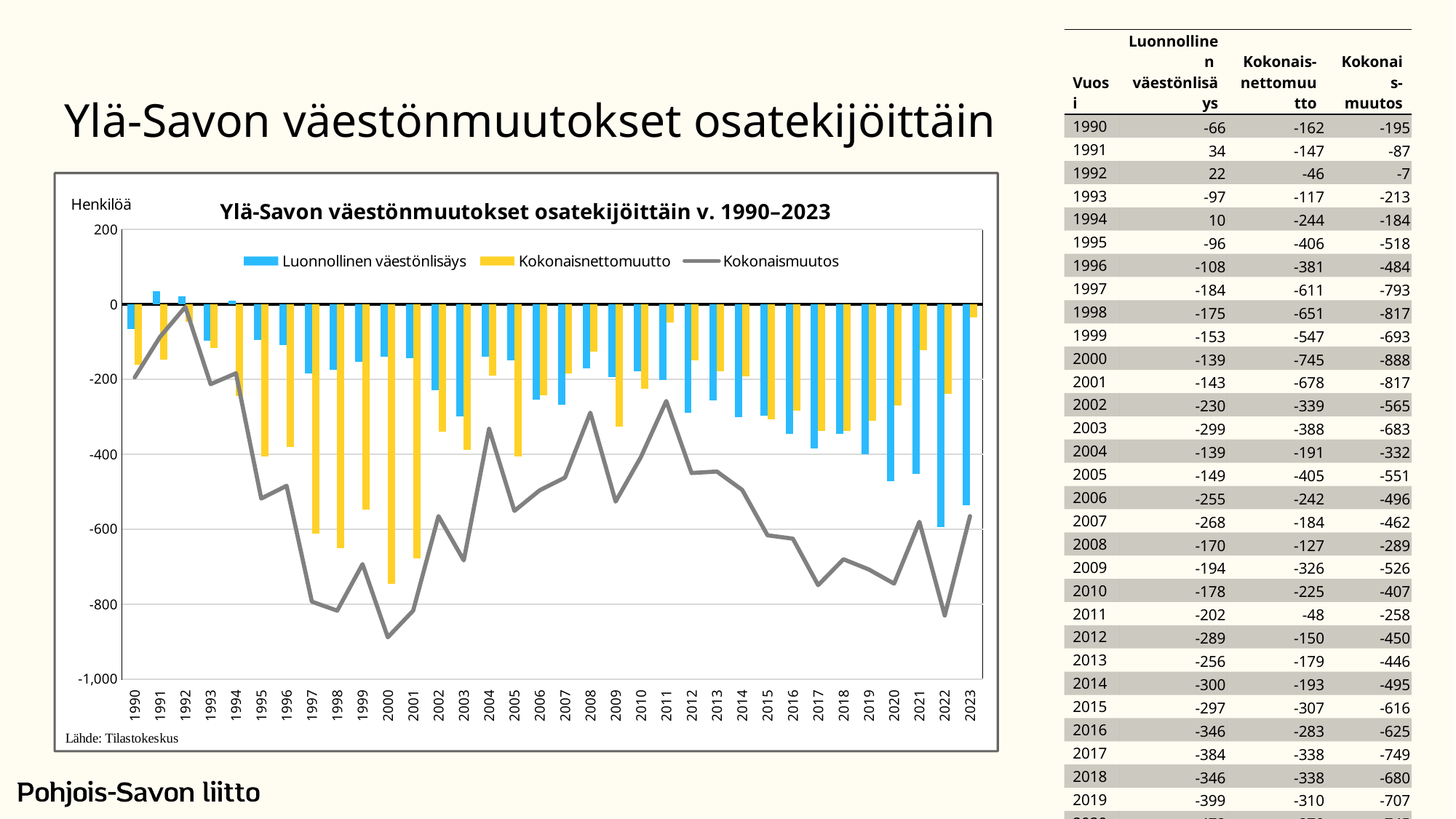
What is the Luonnollinen väestönlisäys value for 2019? -399 Which colour represents Kokonaisnettomuutto in the chart? yellow Is the Kokonaisnettomuutto value for 2000 greater or less than -600? less What kind of chart is shown on the slide? bar chart with a line What is the Kokonaismuutos value for the year 2000? -888 Which year has the larger Luonnollinen väestönlisäys value, 1990 or 1991? 1991 In which year is the Kokonaismuutos line at its highest? 1992 What is the Kokonaisnettomuutto value for 1997? -611 In which year is the Kokonaismuutos line at its lowest? 2000 How many series does the chart legend list? 3 What is the difference between the Kokonaismuutos values for 1992 and 1990? 188 How many years are plotted along the x axis of the chart? 34